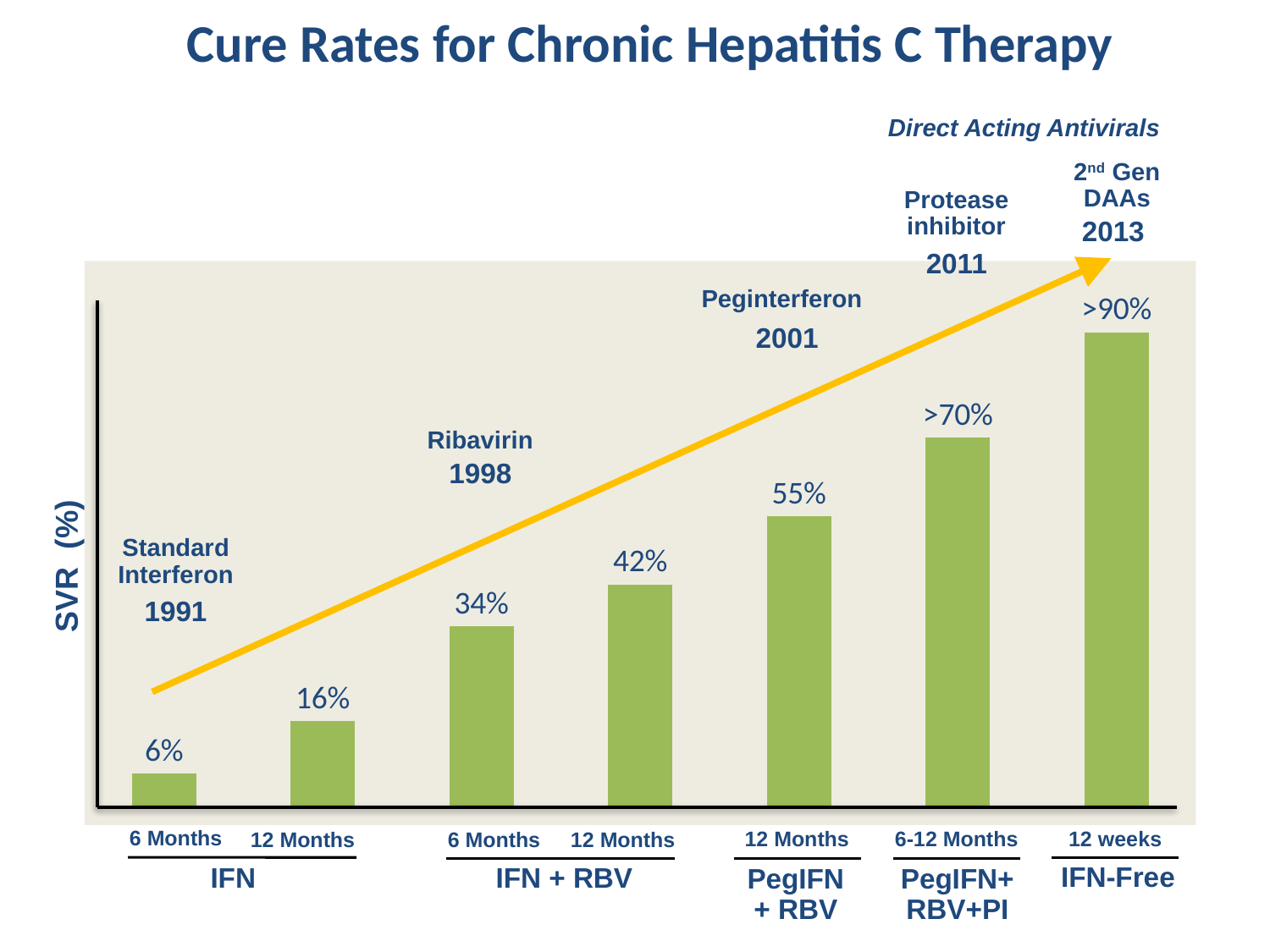
Which has a higher SVR: IFN at 12 Months or IFN + RBV at 6 Months? IFN + RBV at 6 Months Which bar has the lowest SVR? IFN 6 Months How many bars are plotted in the chart? 7 What is the SVR for IFN at 6 Months? 6% What is the difference in SVR between IFN + RBV at 12 Months and IFN + RBV at 6 Months? 8% What is the difference in SVR between PegIFN + RBV at 12 Months and IFN at 12 Months? 39% What is the SVR label shown for PegIFN+RBV+PI at 6-12 Months? >70% What is the SVR for PegIFN + RBV at 12 Months? 55% What kind of chart is shown on the slide? Bar chart Which bar has the highest SVR? IFN-Free 12 weeks What is the SVR for IFN + RBV at 12 Months? 42% What is the SVR label shown for IFN-Free therapy at 12 weeks? >90%